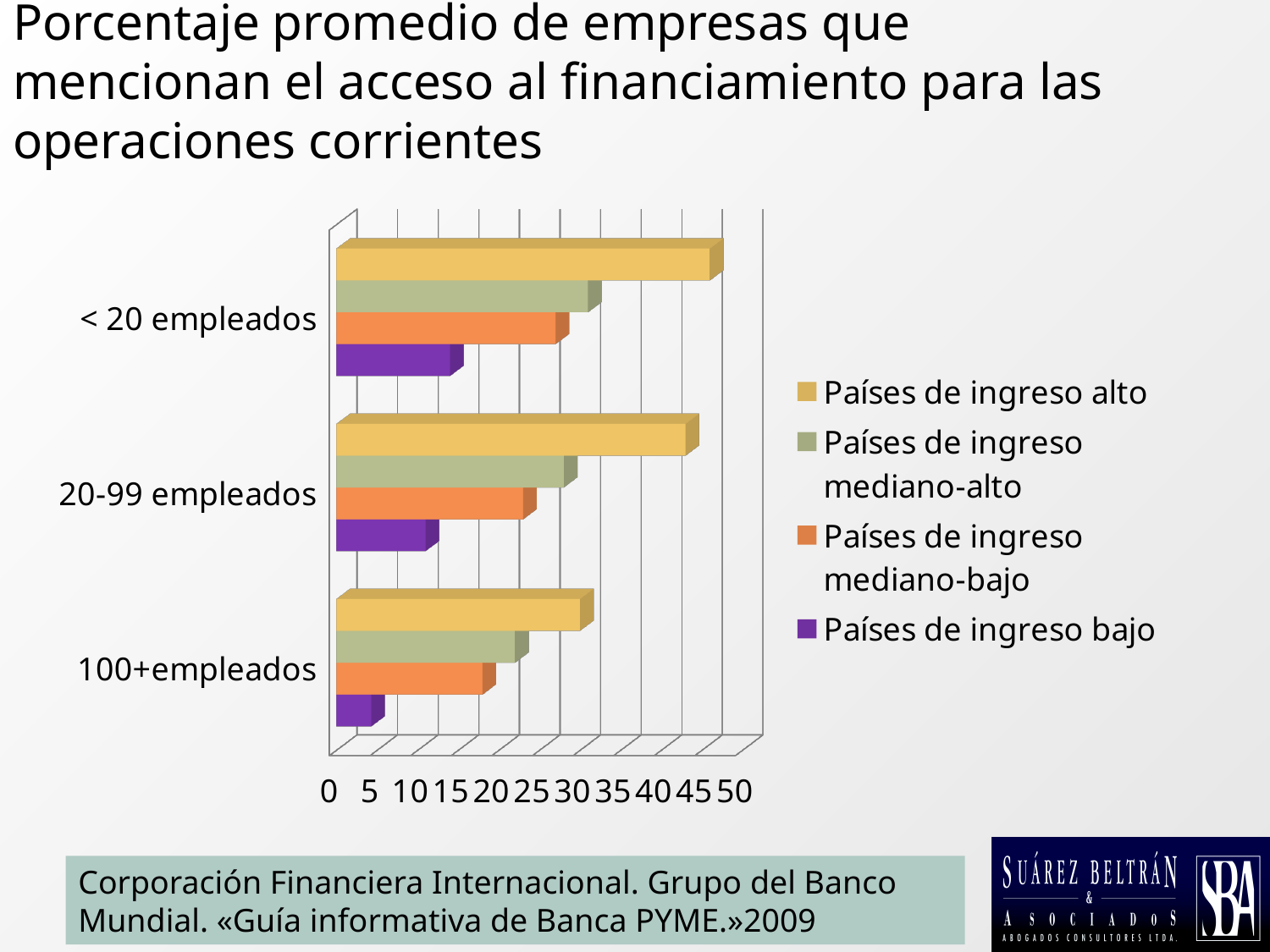
Is the value for 'Países de ingreso bajo' in the '100+empleados' category greater or less than 10? less Which series has the highest value for the '< 20 empleados' category? Países de ingreso alto Which colour represents 'Países de ingreso mediano-bajo' in the legend? Orange Is the value for 'Países de ingreso alto' in the '100+empleados' category greater or less than 25? greater Which series has the lowest value for the '100+empleados' category? Países de ingreso bajo What kind of chart is shown on the slide? Bar chart Which is larger: the 'Países de ingreso alto' value for '< 20 empleados' or for '100+empleados'? < 20 empleados How many series does the legend list? 4 Is the value for 'Países de ingreso bajo' in the '< 20 empleados' category greater or less than 20? less How many employee-size categories are shown on the chart? 3 For 'Países de ingreso bajo', do the values rise or fall as company size increases from '< 20 empleados' to '100+empleados'? fall